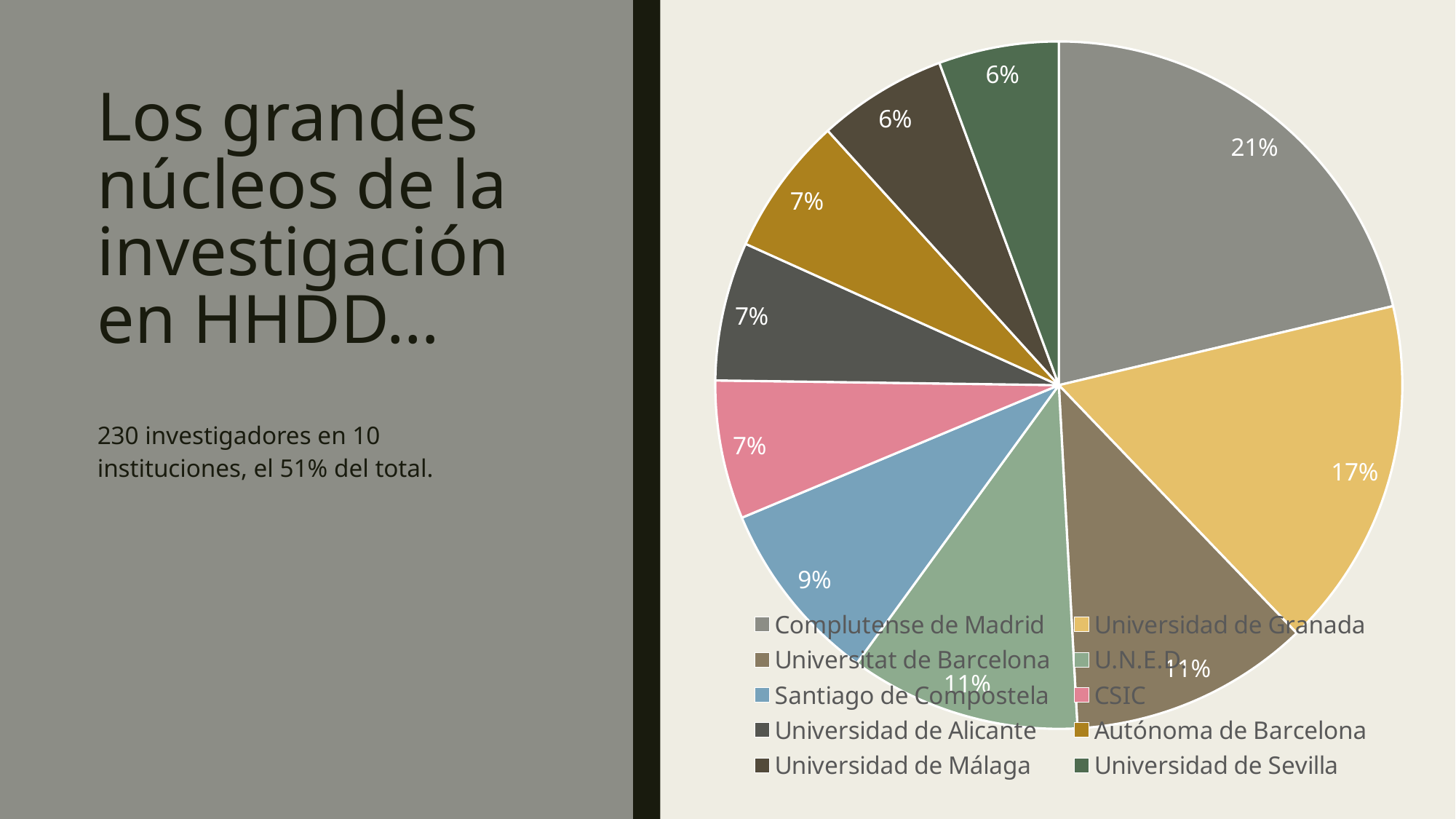
How many entries does the legend of the pie chart list? 10 What kind of chart is shown on the slide? pie chart What is the value shown for Universidad de Sevilla? 6% What is the difference in percentage points between Complutense de Madrid and Universidad de Granada? 4 Which institution is represented by the pink slice? CSIC Which has a larger share, Santiago de Compostela or Universidad de Málaga? Santiago de Compostela How many slices does the pie chart have? 10 What is the value shown for Universidad de Granada? 17% What is the value shown for CSIC? 7% Which institution has the largest slice of the pie? Complutense de Madrid What share of the pie does Complutense de Madrid have? 21% What is the value shown for Santiago de Compostela? 9%